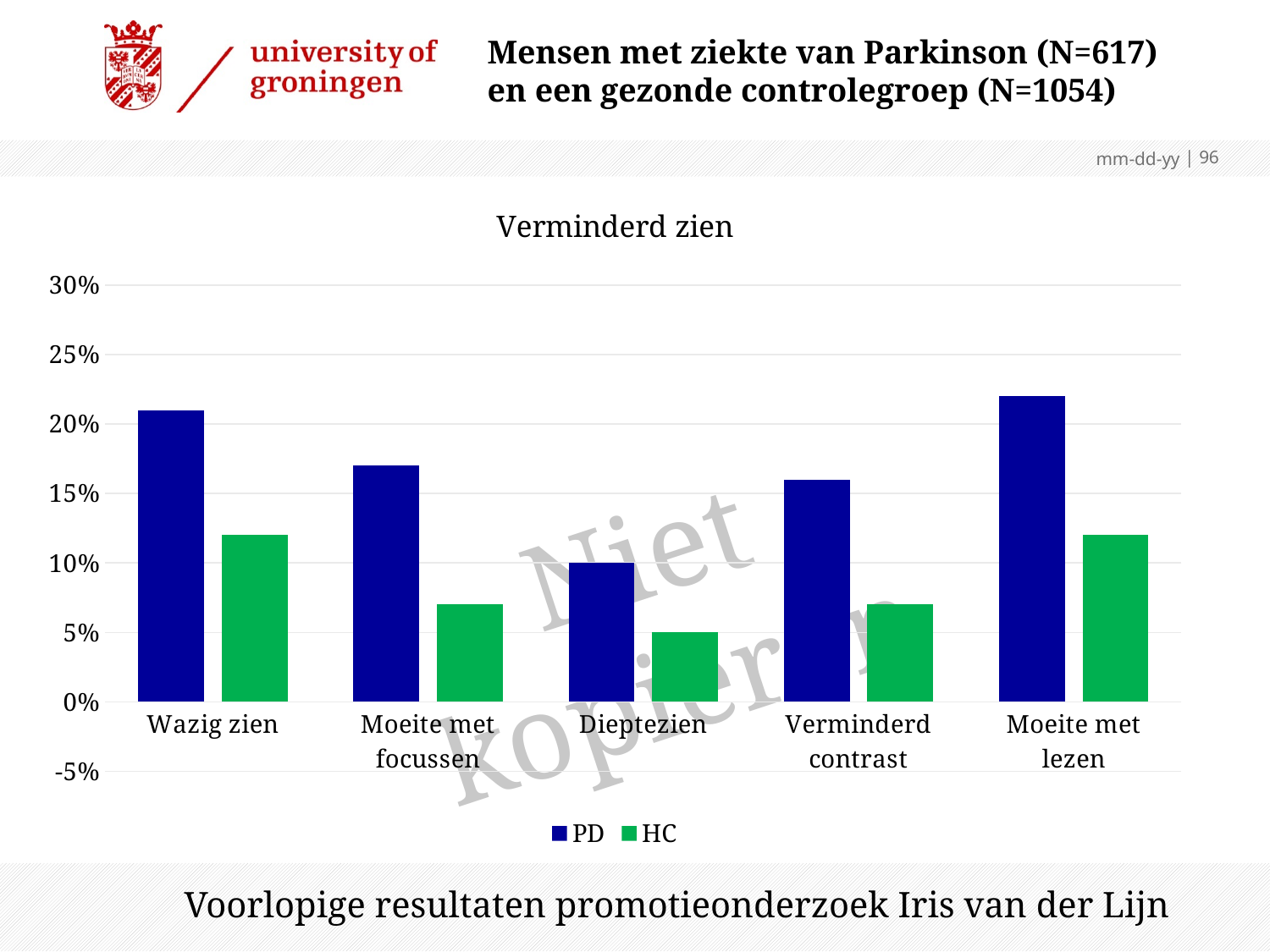
What kind of chart is shown on the slide? bar chart How many categories are shown on the x axis? 5 How many series does the legend list? 2 What is the title of the chart? Verminderd zien Is the HC value for Moeite met focussen greater or less than 10%? less Is the PD value for Moeite met lezen greater or less than 20%? greater For Wazig zien, which series has the larger value, PD or HC? PD What is the HC value for Dieptezien? 5% Which category has the lowest PD value? Dieptezien Which category has the lowest HC value? Dieptezien Which colour represents the HC series in the legend? green What is the PD value for Dieptezien? 10%